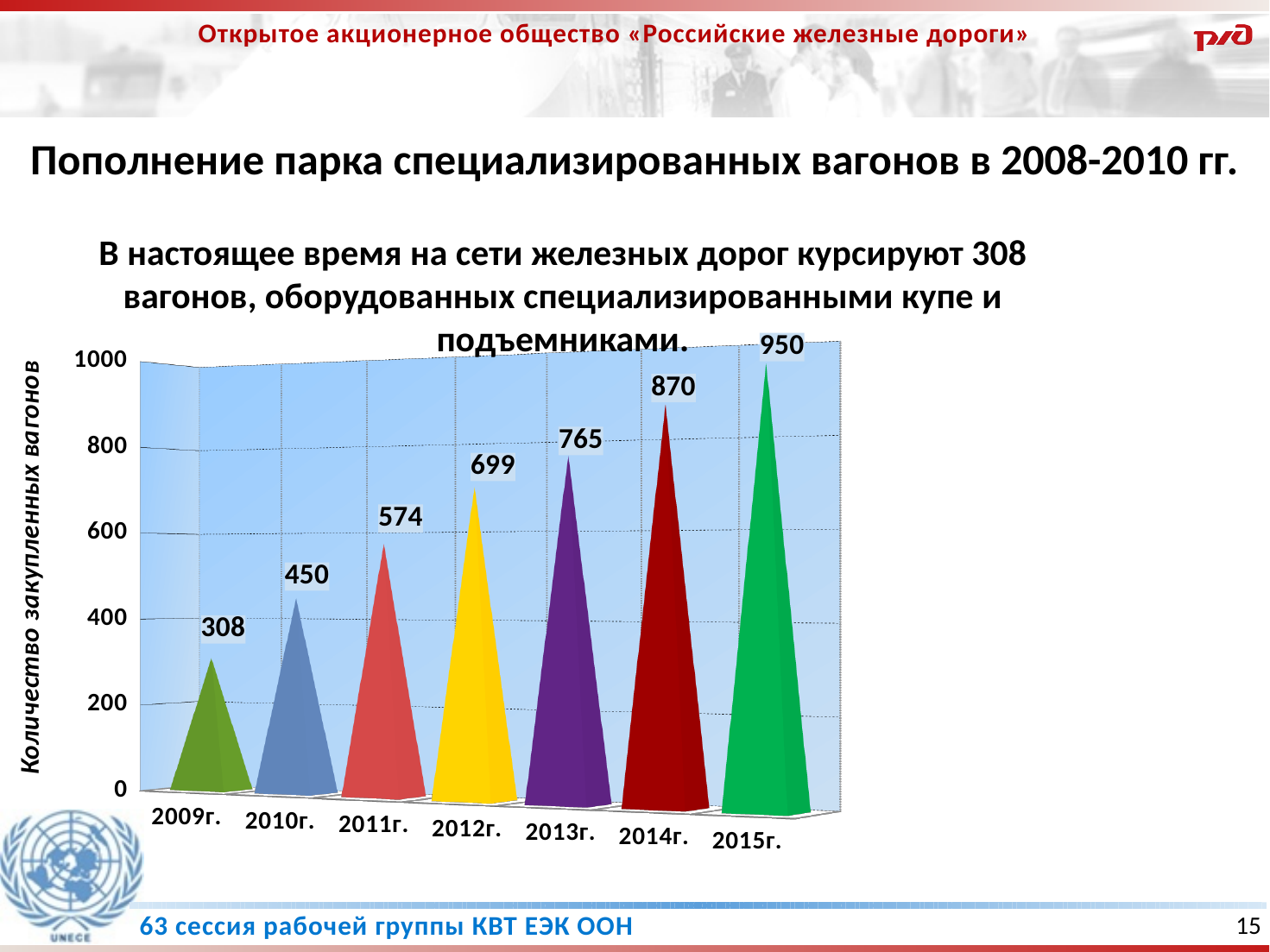
What is the difference between the values for 2015г. and 2014г.? 80 Do the values rise or fall from 2009г. to 2015г.? rise What is the difference between the values for 2011г. and 2010г.? 124 What is the value for 2009г.? 308 Which is larger, the value for 2013г. or the value for 2012г.? 2013г. Is the value for 2011г. greater or less than 600? less What kind of chart is shown on the slide? bar chart What is the value for 2014г.? 870 How many years are shown on the x axis? 7 Which year has the highest value? 2015г. What is the value for 2012г.? 699 Which year has the lowest value? 2009г.